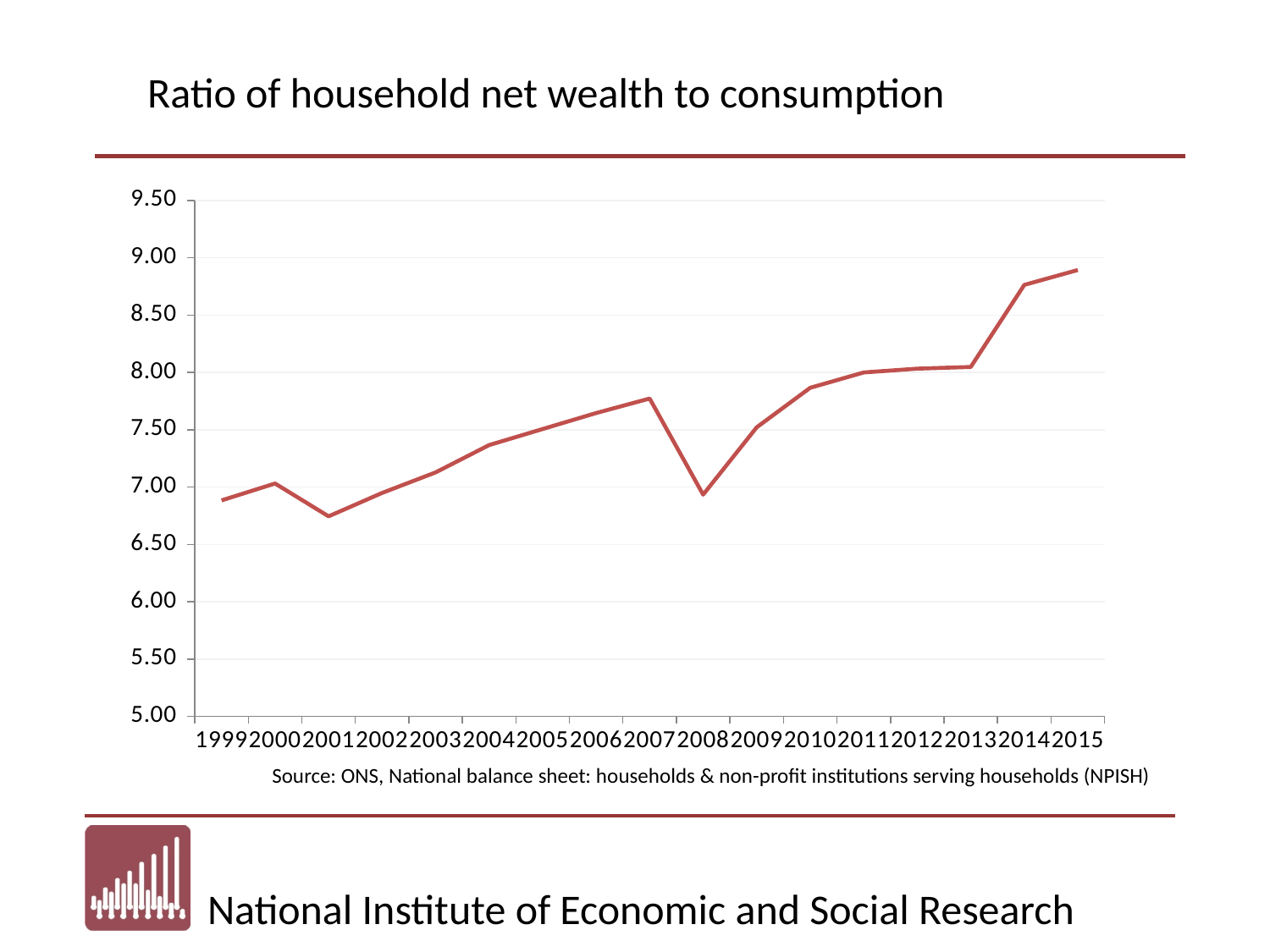
In which year is the ratio of household net wealth to consumption lowest? 2001 Which year has the larger value, 2013 or 2014? 2014 Is the value for 2007 greater or less than 7.50? greater Is the value for 2008 greater or less than 7.00? less Is the value for 2001 greater or less than 7.00? less Does the ratio rise or fall between 2013 and 2015? rise What is the title of the chart? Ratio of household net wealth to consumption Which year has the larger value, 2007 or 2008? 2007 In which year is the ratio of household net wealth to consumption highest? 2015 What kind of chart is shown on the slide? line chart How many years are plotted along the x axis? 17